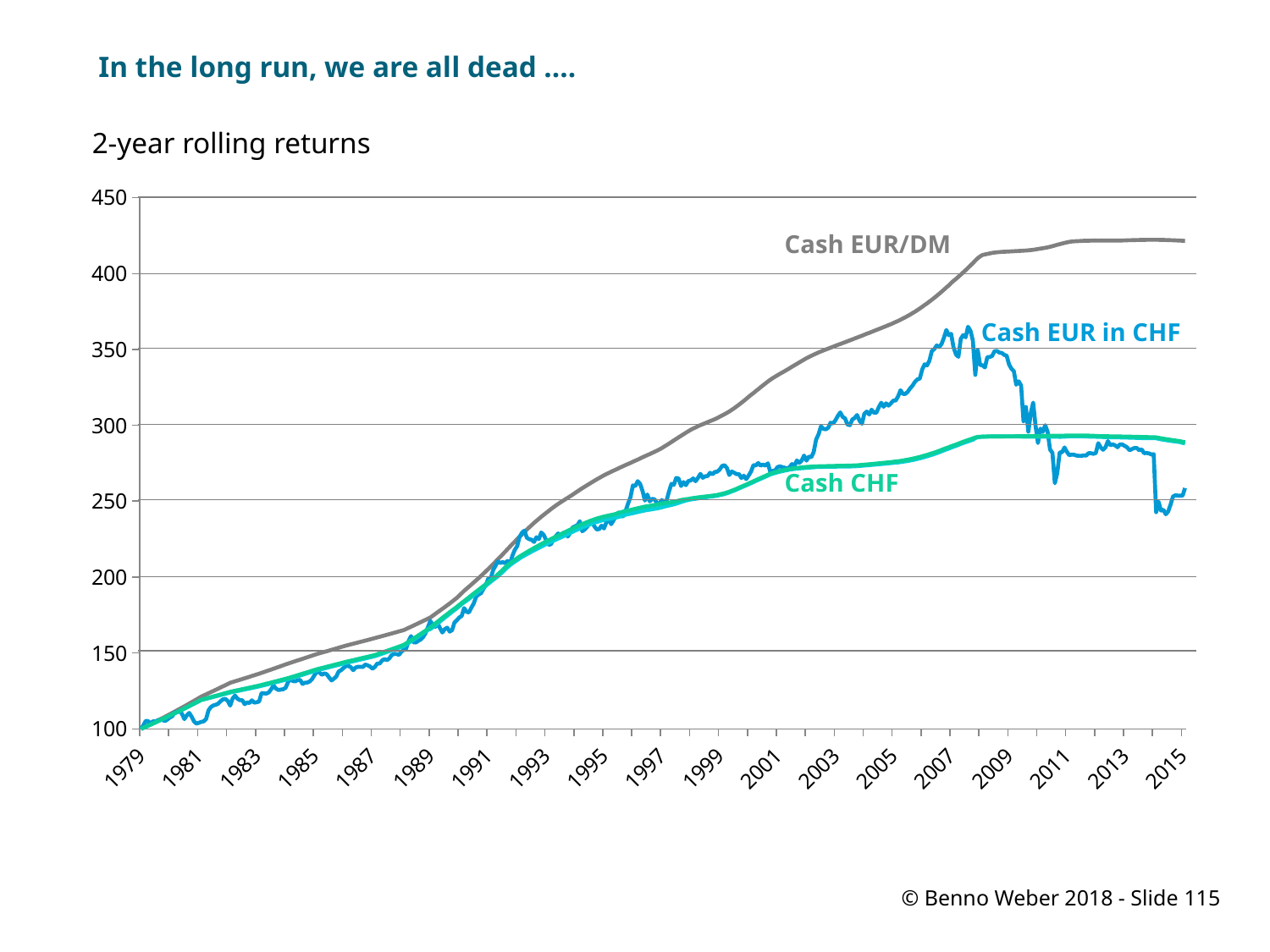
Which series has the lowest value at the end of the chart in 2015? Cash EUR in CHF At what value do all three series start in 1979? 100 Is the value for Cash CHF in 1991 greater or less than 250? less In 2005, which is larger: Cash EUR in CHF or Cash CHF? Cash EUR in CHF Does the Cash EUR/DM series rise or fall from 1979 to 2015? rise Is the value for Cash EUR/DM in 2001 greater or less than 300? greater How many series are plotted on the chart? 3 Which series has the highest value at the end of the chart in 2015? Cash EUR/DM What kind of chart is shown on the slide? line chart Is the value for Cash CHF in 2015 greater or less than 300? less What is the title of the chart? 2-year rolling returns